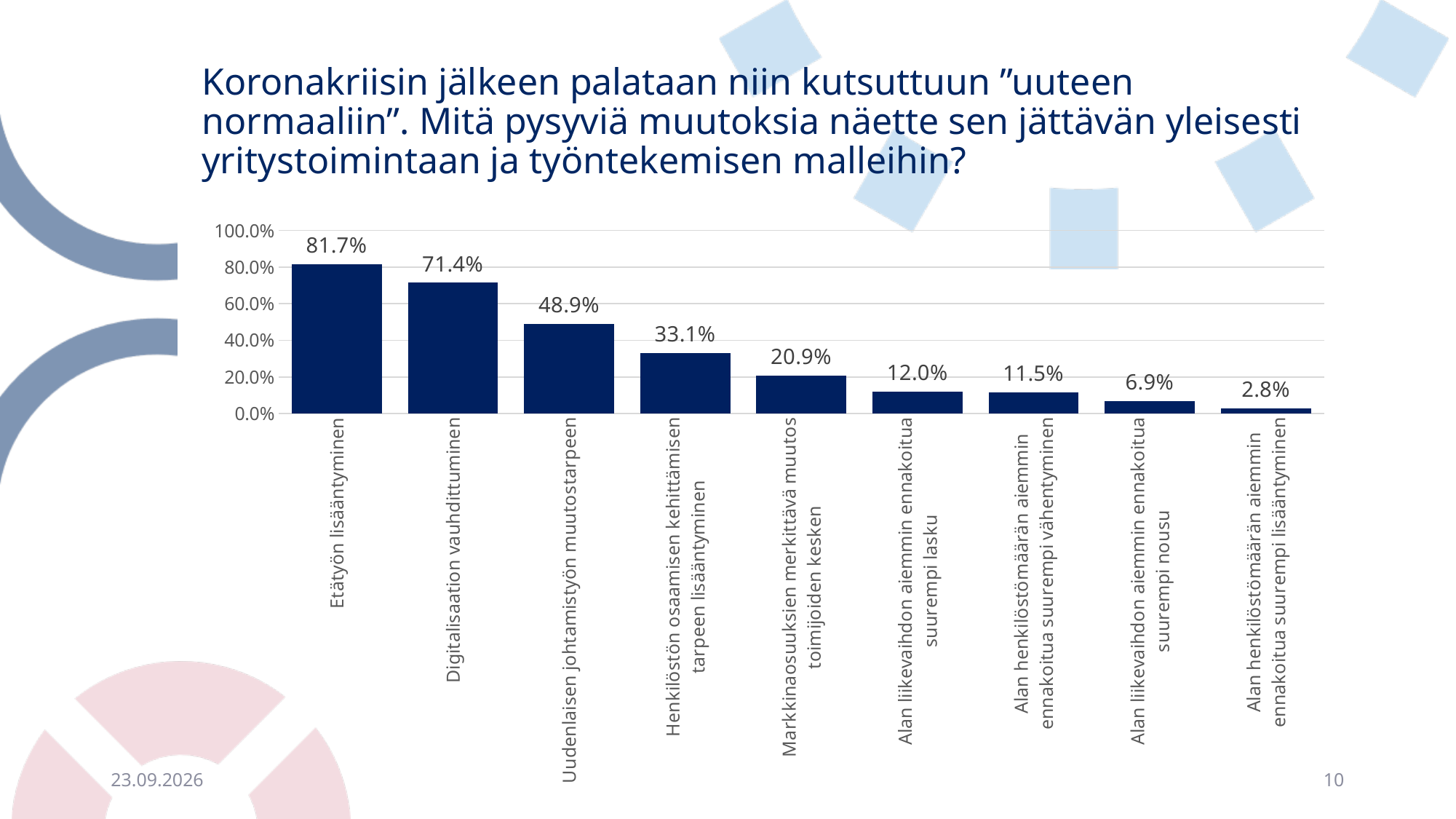
Which is larger: the value for Uudenlaisen johtamistyön muutostarpeen or the value for Henkilöstön osaamisen kehittämisen tarpeen lisääntyminen? Uudenlaisen johtamistyön muutostarpeen What is the difference between the values for Etätyön lisääntyminen and Digitalisaation vauhdittuminen? 10.3% Do the values rise or fall from left to right along the x axis? fall Which category has the lowest value? Alan henkilöstömäärän aiemmin ennakoitua suurempi lisääntyminen What is the value for Alan liikevaihdon aiemmin ennakoitua suurempi nousu? 6.9% What is the value for Etätyön lisääntyminen? 81.7% What is the value for Digitalisaation vauhdittuminen? 71.4% How many categories are shown in the chart? 9 Is the value for Henkilöstön osaamisen kehittämisen tarpeen lisääntyminen greater or less than 40.0%? less What kind of chart is shown on the slide? bar chart Which category has the highest value? Etätyön lisääntyminen What is the value for Markkinaosuuksien merkittävä muutos toimijoiden kesken? 20.9%